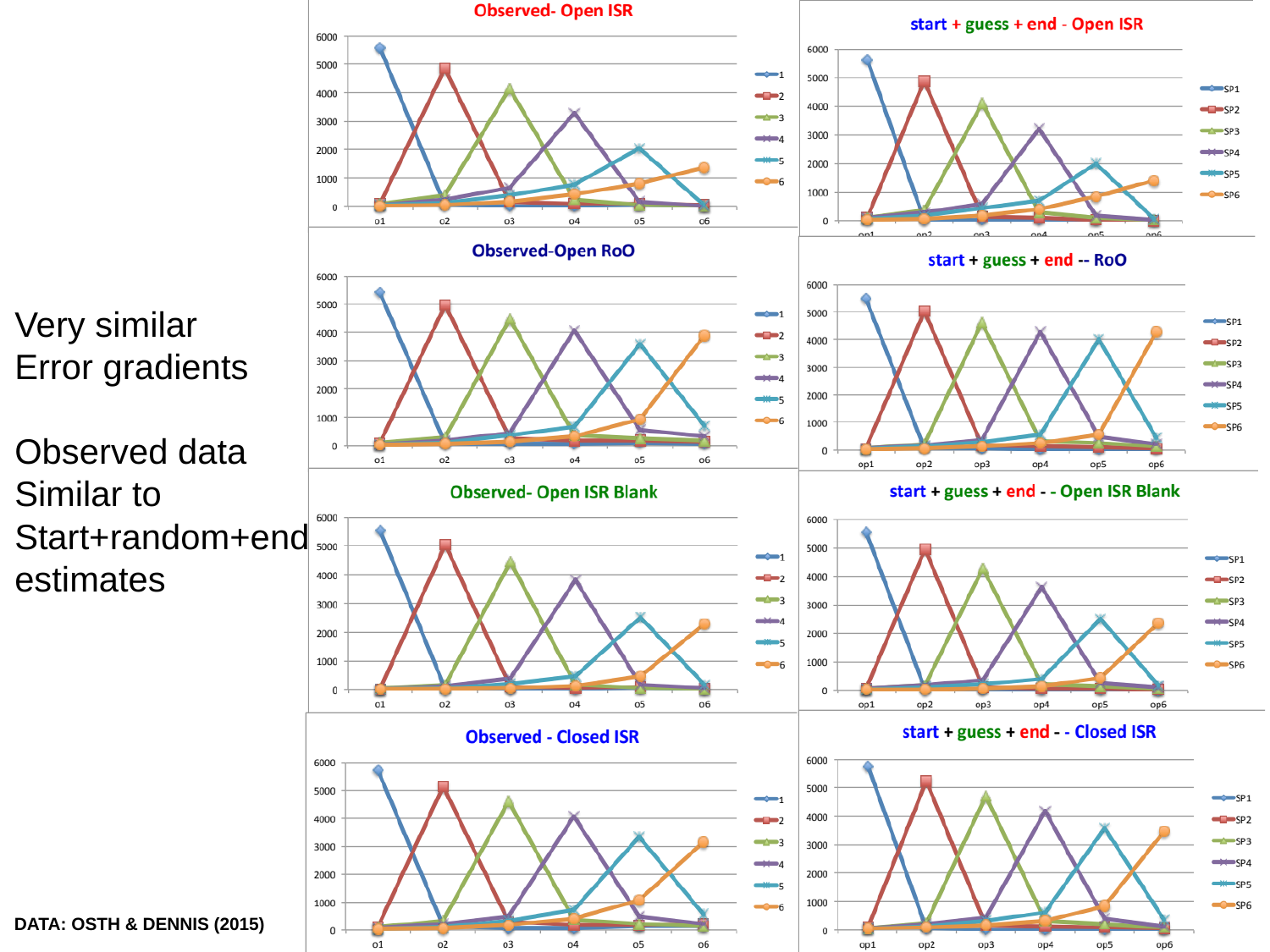
In the "Observed- Open ISR Blank" chart, which series reaches the highest peak value? 1 In the "start + guess + end - - Closed ISR" chart, does SP6 rise or fall from op4 to op6? rise In the "Observed- Open ISR" chart, is the value of series 6 at o6 greater or less than 1000? greater How many series does the legend of the "Observed- Open ISR" chart list? 6 In the "Observed-Open RoO" chart, is the value of series 6 at o6 greater or less than 3000? greater What kind of chart is the "Observed- Open ISR" chart? line chart In the "start + guess + end -- RoO" chart, is the value of SP6 at op6 greater or less than 4000? greater How many categories are on the x axis of the "Observed-Open RoO" chart? 6 In the "Observed- Open ISR" chart, at which x-axis category does series 1 reach its highest value? o1 What are the legend entries of the "start + guess + end - Open ISR" chart? SP1, SP2, SP3, SP4, SP5, SP6